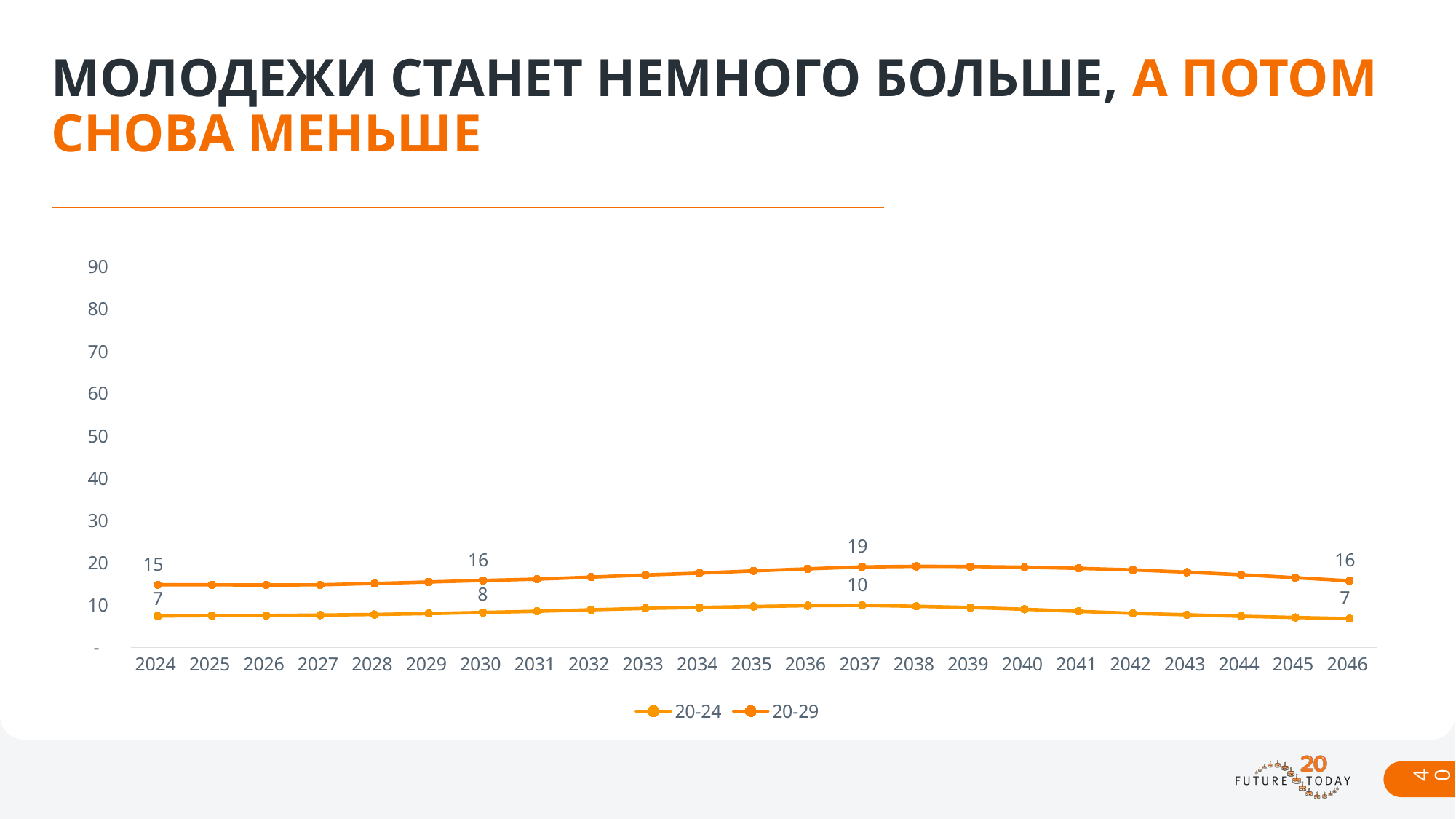
How many series does the legend list? 2 Is the value of the upper line in 2040 greater or less than 30? less What is the labelled value of the lower line in 2024? 7 By how much does the upper line's labelled value in 2037 exceed its value in 2024? 4 How many years are shown along the x axis? 23 What is the labelled value of the lower line in 2030? 8 What are the two entries in the chart legend? 20-24 and 20-29 Does the lower line rise or fall from 2037 to 2046? fall What kind of chart is shown on the slide? line chart What is the labelled value of the upper line in 2037? 19 What is the difference between the upper and lower line values in 2037? 9 What is the labelled value of the upper line in 2046? 16